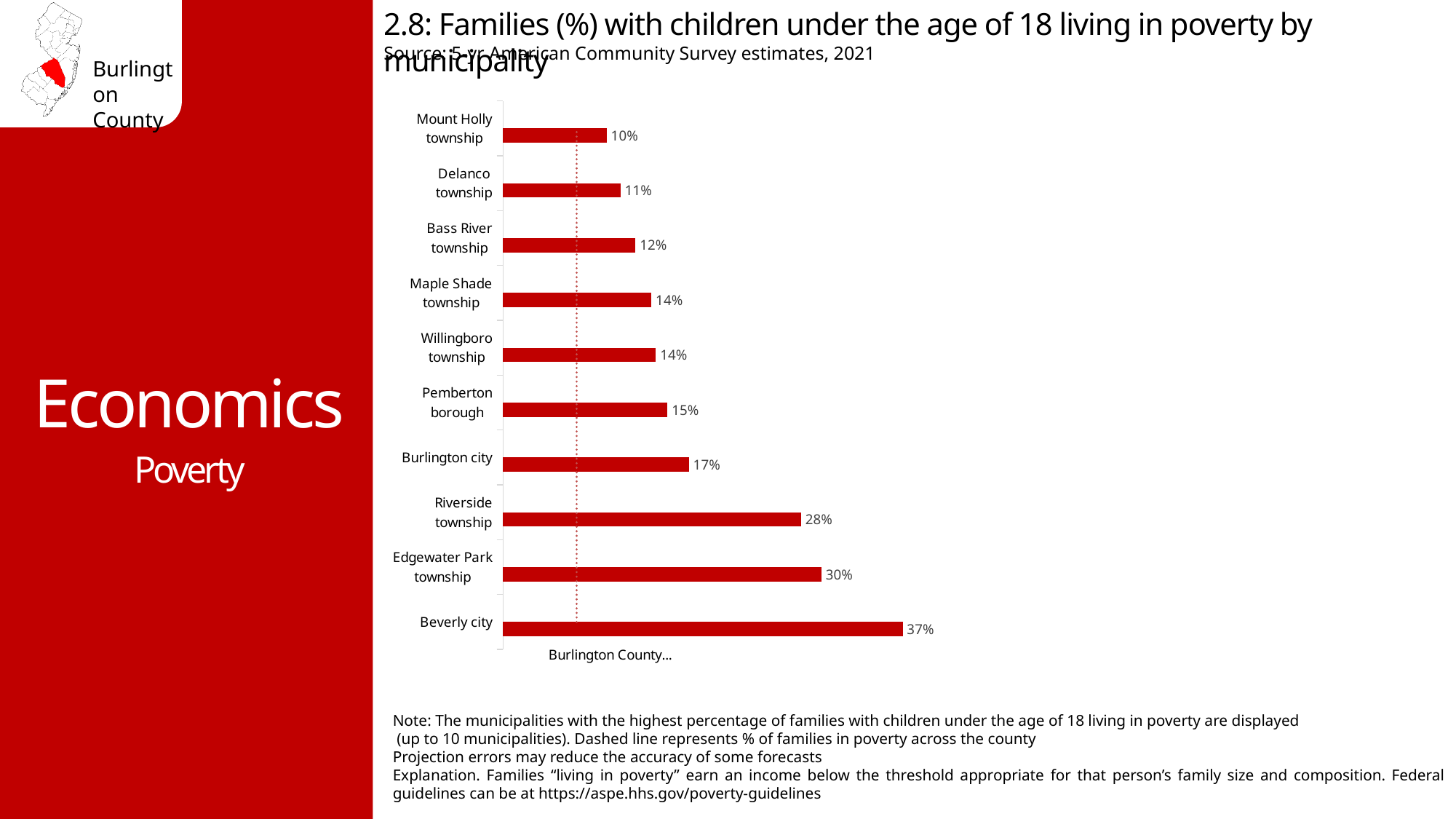
Which municipality has the lowest percentage shown on the chart? Mount Holly township What is the value shown for Riverside township? 28% Which municipality has the highest percentage of families with children under 18 living in poverty? Beverly city What is the difference between the values for Burlington city and Delanco township? 6% What is the value shown for Pemberton borough? 15% What percentage of families with children under 18 are living in poverty in Beverly city? 37% What kind of chart is shown on the slide? Bar chart What is the difference between the values for Beverly city and Edgewater Park township? 7% What does the dashed vertical line on the chart represent? % of families in poverty across the county Which two municipalities both have a value of 14%? Maple Shade township and Willingboro township Which has a higher value, Riverside township or Burlington city? Riverside township How many municipalities are shown on the chart? 10